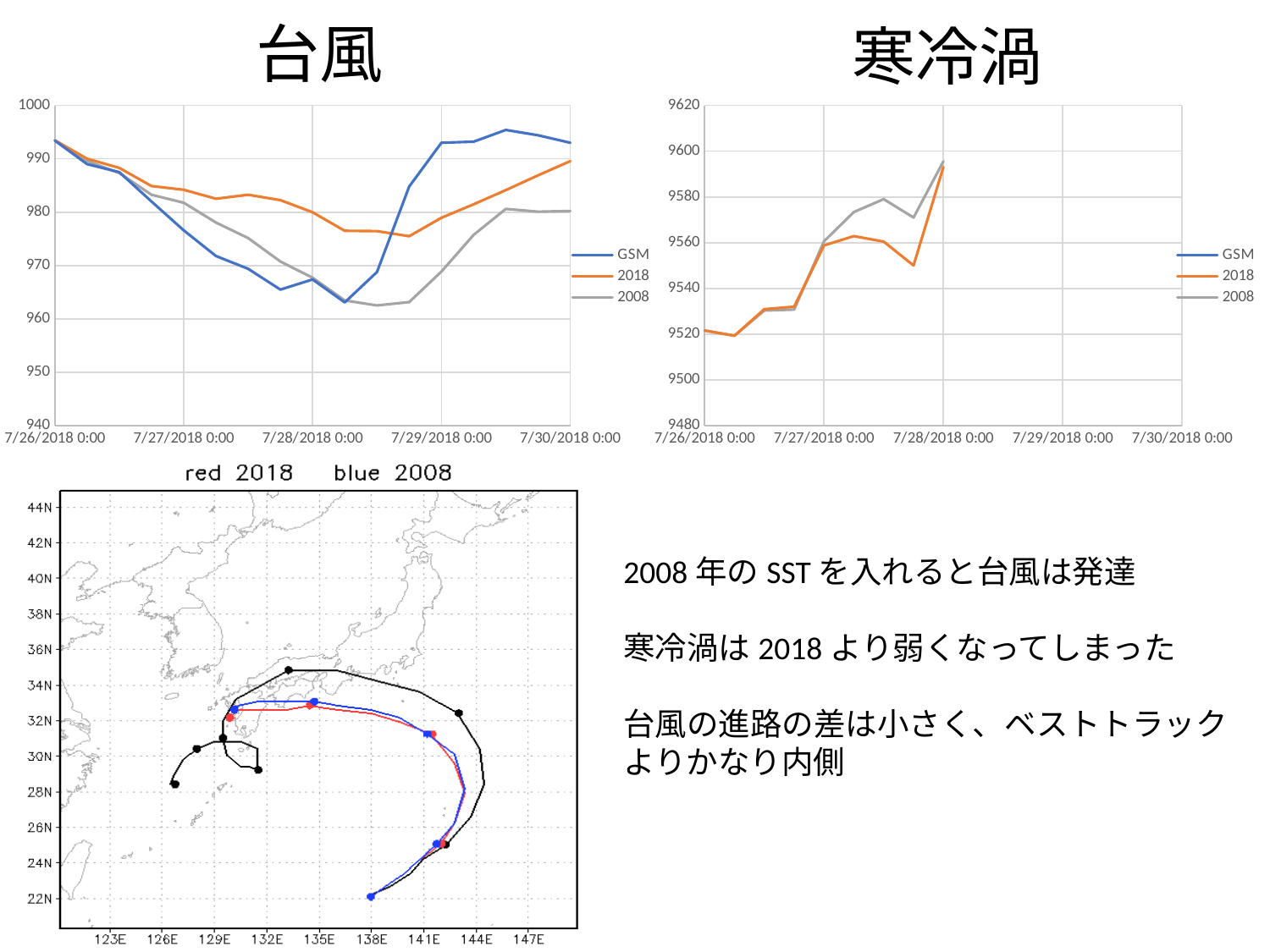
What are the legend entries of the 台風 chart? GSM, 2018, 2008 In the 寒冷渦 chart, is the 2018 value at 7/28/2018 0:00 greater or less than 9580? greater What kind of chart is the 台風 chart? line chart In the 寒冷渦 chart, do the values rise or fall overall from 7/26/2018 0:00 to 7/28/2018 0:00? rise In the 台風 chart, is the lowest value of the 2018 series greater or less than 970? greater How many series does the legend of the 寒冷渦 chart list? 3 In the 台風 chart, at 7/29/2018 0:00, which series has the higher value, GSM or 2008? GSM In the 寒冷渦 chart, is the value at 7/26/2018 0:00 greater or less than 9540? less What is the title of the chart on the right? 寒冷渦 In the 台風 chart, does the GSM series rise or fall from 7/26/2018 0:00 to 7/28/2018 0:00? fall In the 台風 chart, at 7/28/2018 0:00, which series has the higher value, GSM or 2018? 2018